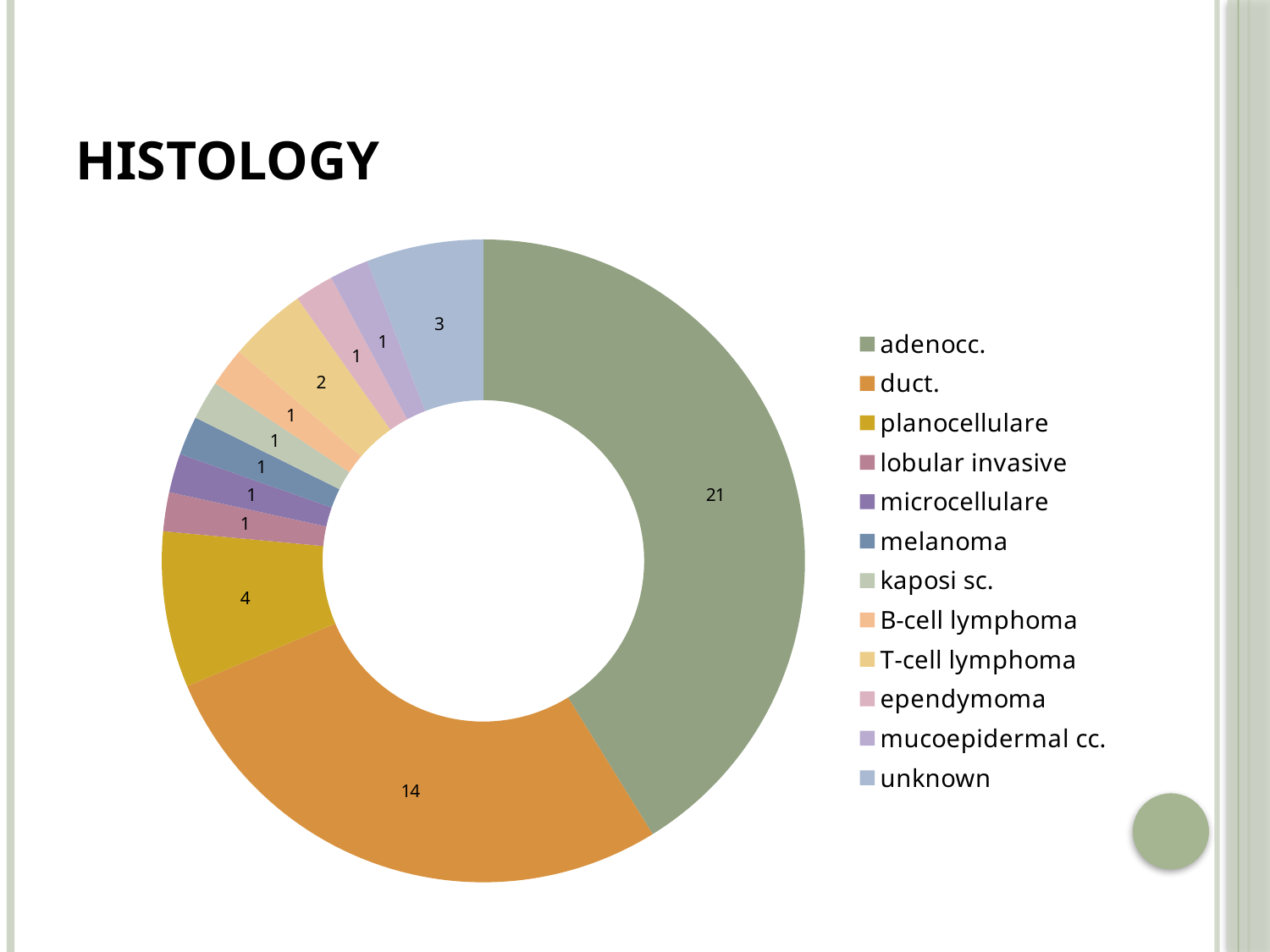
What is the value for T-cell lymphoma? 2 Which is larger, the value for planocellulare or the value for unknown? planocellulare What is the value for duct.? 14 What is the value for unknown? 3 What type of chart is shown on the slide? doughnut chart What is the total of all the values in the chart? 51 Which category has the largest value? adenocc. What is the value for planocellulare? 4 What is the value for adenocc.? 21 What is the title of the slide? HISTOLOGY How many categories does the legend list? 12 What is the difference between the values for adenocc. and duct.? 7